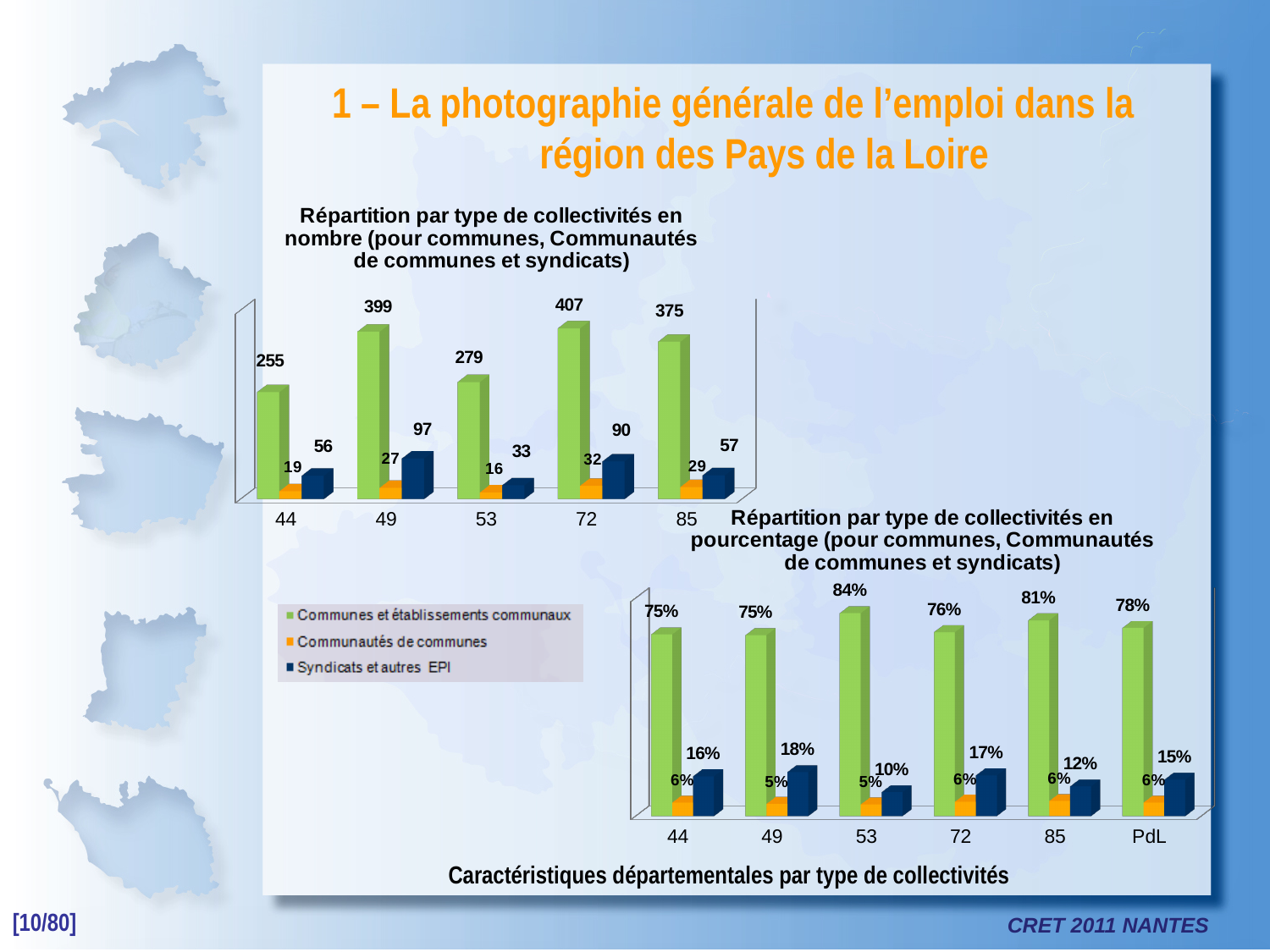
In the chart 'Répartition par type de collectivités en pourcentage', what is the value for Communes et établissements communaux for category 53? 84% How many series does the legend list for the charts on the slide? 3 In the chart 'Répartition par type de collectivités en nombre', how many categories are shown on the x axis? 5 In the chart 'Répartition par type de collectivités en nombre', which category has the lowest value for Communautés de communes? 53 In the chart 'Répartition par type de collectivités en nombre', what is the difference between the Communes et établissements communaux values for 49 and 44? 144 In the chart 'Répartition par type de collectivités en nombre', what is the value for Syndicats et autres EPI for category 49? 97 In the chart 'Répartition par type de collectivités en nombre', which category has the highest value for Communes et établissements communaux? 72 In the chart 'Répartition par type de collectivités en pourcentage', is the Syndicats et autres EPI value for 85 larger or smaller than the value for 72? smaller In the chart 'Répartition par type de collectivités en pourcentage', which category has the highest value for Syndicats et autres EPI? 49 In the chart 'Répartition par type de collectivités en nombre', what is the value for Communes et établissements communaux for category 72? 407 In the chart 'Répartition par type de collectivités en pourcentage', how many categories are shown on the x axis? 6 In the chart 'Répartition par type de collectivités en pourcentage', what is the value for Syndicats et autres EPI for PdL? 15%